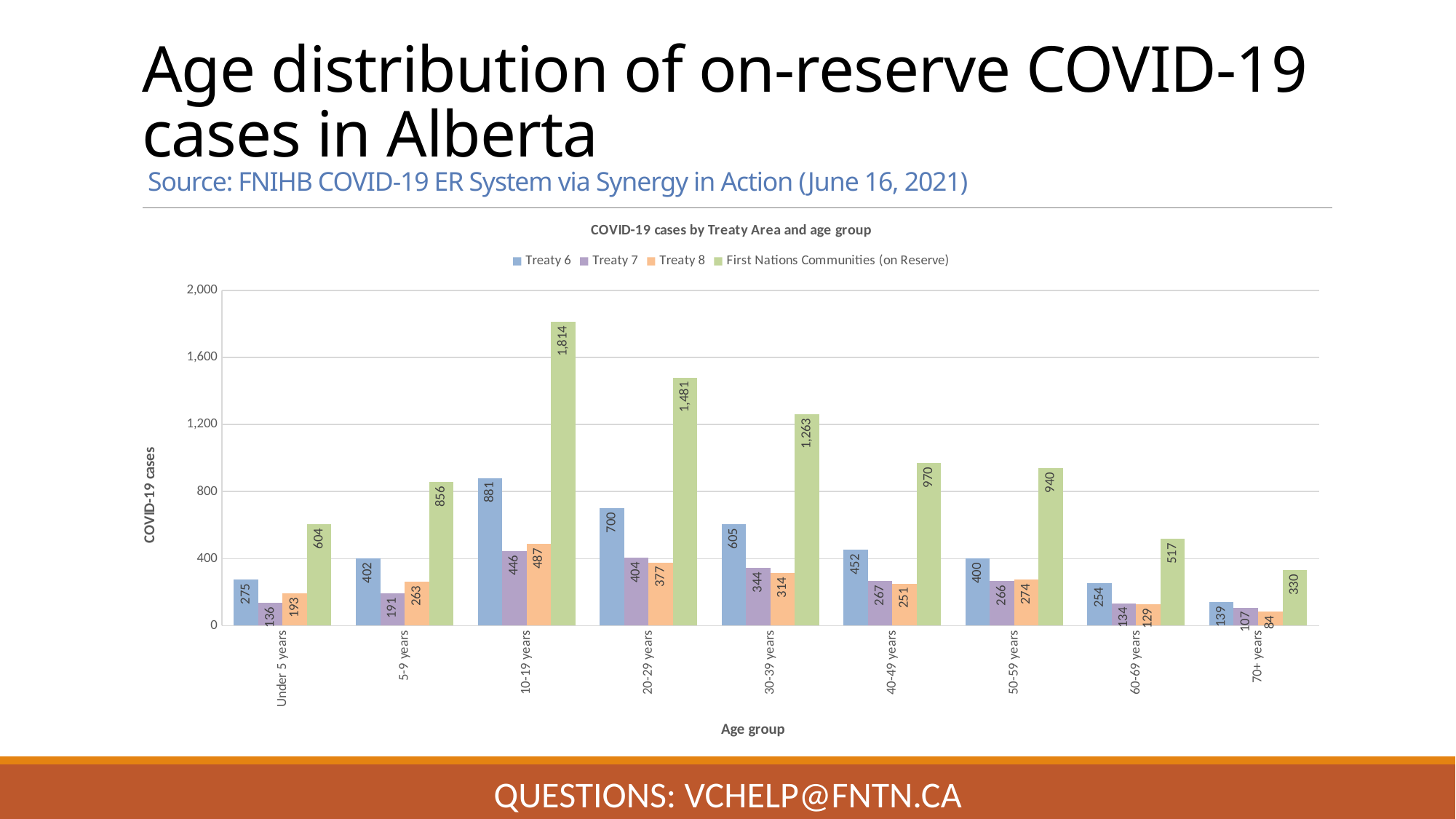
What kind of chart is shown on the slide? Bar chart What is the value for Treaty 8 in the 70+ years age group? 84 What is the title of the chart? COVID-19 cases by Treaty Area and age group How many age groups are shown on the x axis? 9 What is the value for First Nations Communities (on Reserve) in the 20-29 years age group? 1,481 Which is larger in the 5-9 years age group: Treaty 7 or Treaty 8? Treaty 8 How many series does the legend list? 4 Which age group has the highest value for First Nations Communities (on Reserve)? 10-19 years What is the difference between the Treaty 6 and Treaty 7 values in the 20-29 years age group? 296 Which age group has the lowest value for Treaty 7? 70+ years What is the value for Treaty 6 in the 10-19 years age group? 881 Is the value for First Nations Communities (on Reserve) in the 30-39 years age group greater or less than 1,200? greater